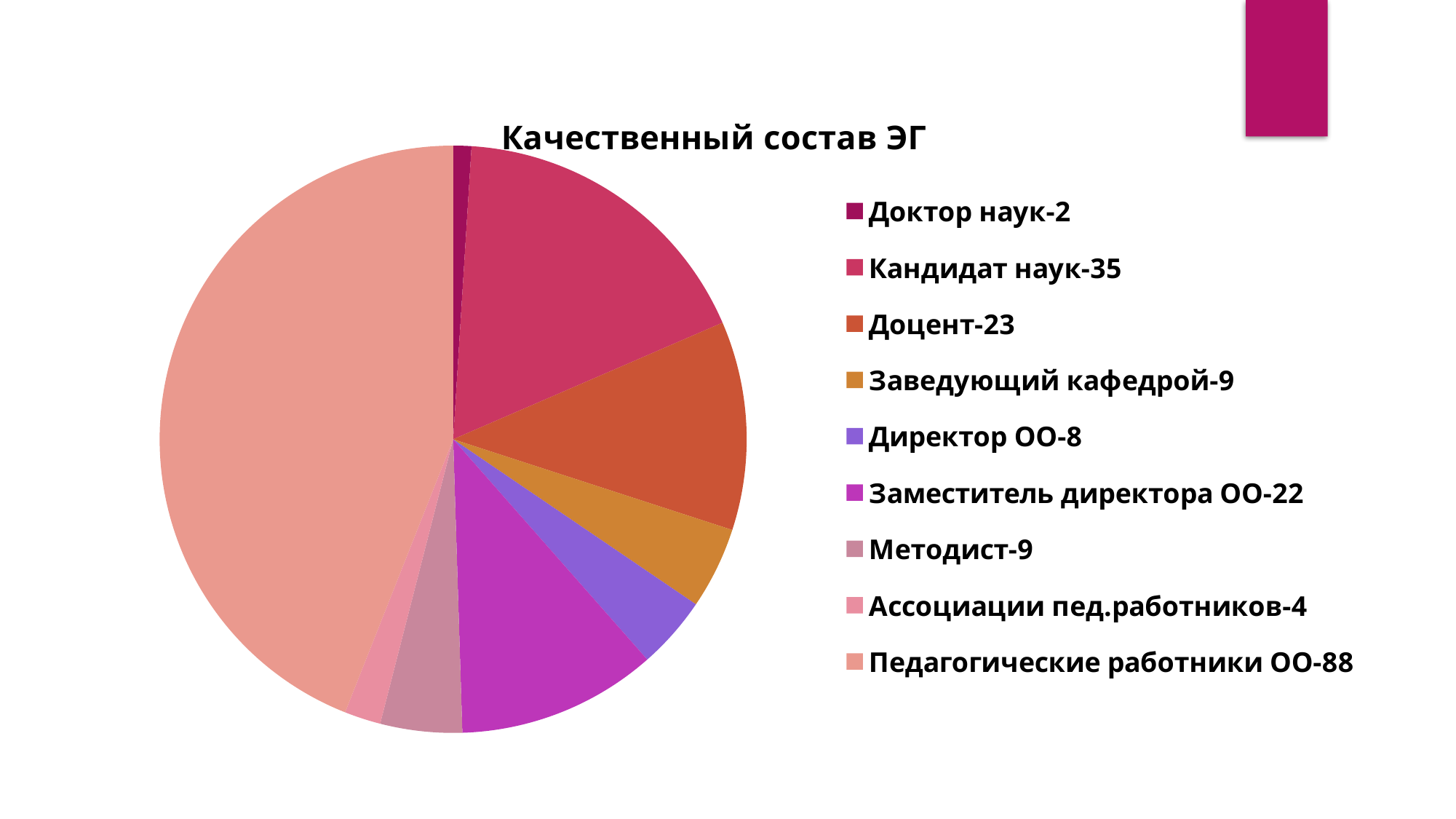
What kind of chart is shown on the slide? Pie chart What is the value for Ассоциации пед.работников? 4 What share of the pie does Педагогические работники ОО represent? 44% How many categories does the pie chart have? 9 What is the difference between the values for Педагогические работники ОО and Кандидат наук? 53 What is the total of all the values in the pie chart? 200 Which category has the largest slice of the pie? Педагогические работники ОО Which category has the smallest slice of the pie? Доктор наук Which is larger, the value for Доцент or the value for Заместитель директора ОО? Доцент What is the value for Заместитель директора ОО? 22 What is the title of the chart? Качественный состав ЭГ What is the value for Кандидат наук? 35